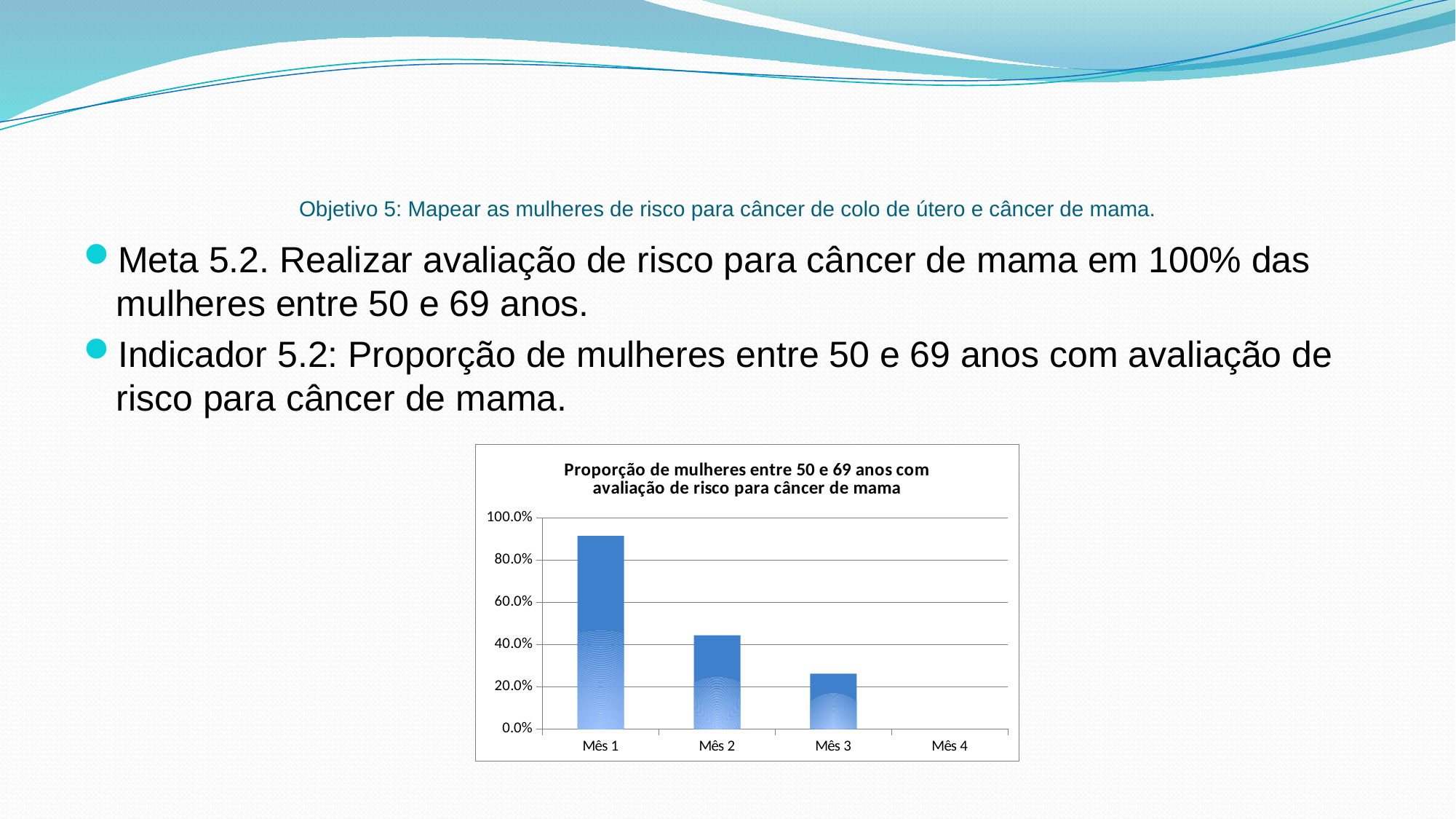
What kind of chart is shown on the slide? bar chart Which month has the highest proportion in the chart? Mês 1 Is the value for Mês 1 greater or less than 80.0%? greater Do the values rise or fall from Mês 1 to Mês 4? fall Is the value for Mês 3 greater or less than 20.0%? greater Is the value for Mês 2 greater or less than 40.0%? greater Which month has the lowest proportion in the chart? Mês 4 What is the highest value shown on the y axis of the chart? 100.0% How many categories are shown on the x axis of the chart? 4 Which is larger, the value for Mês 2 or the value for Mês 3? Mês 2 What is the title of the chart? Proporção de mulheres entre 50 e 69 anos com avaliação de risco para câncer de mama